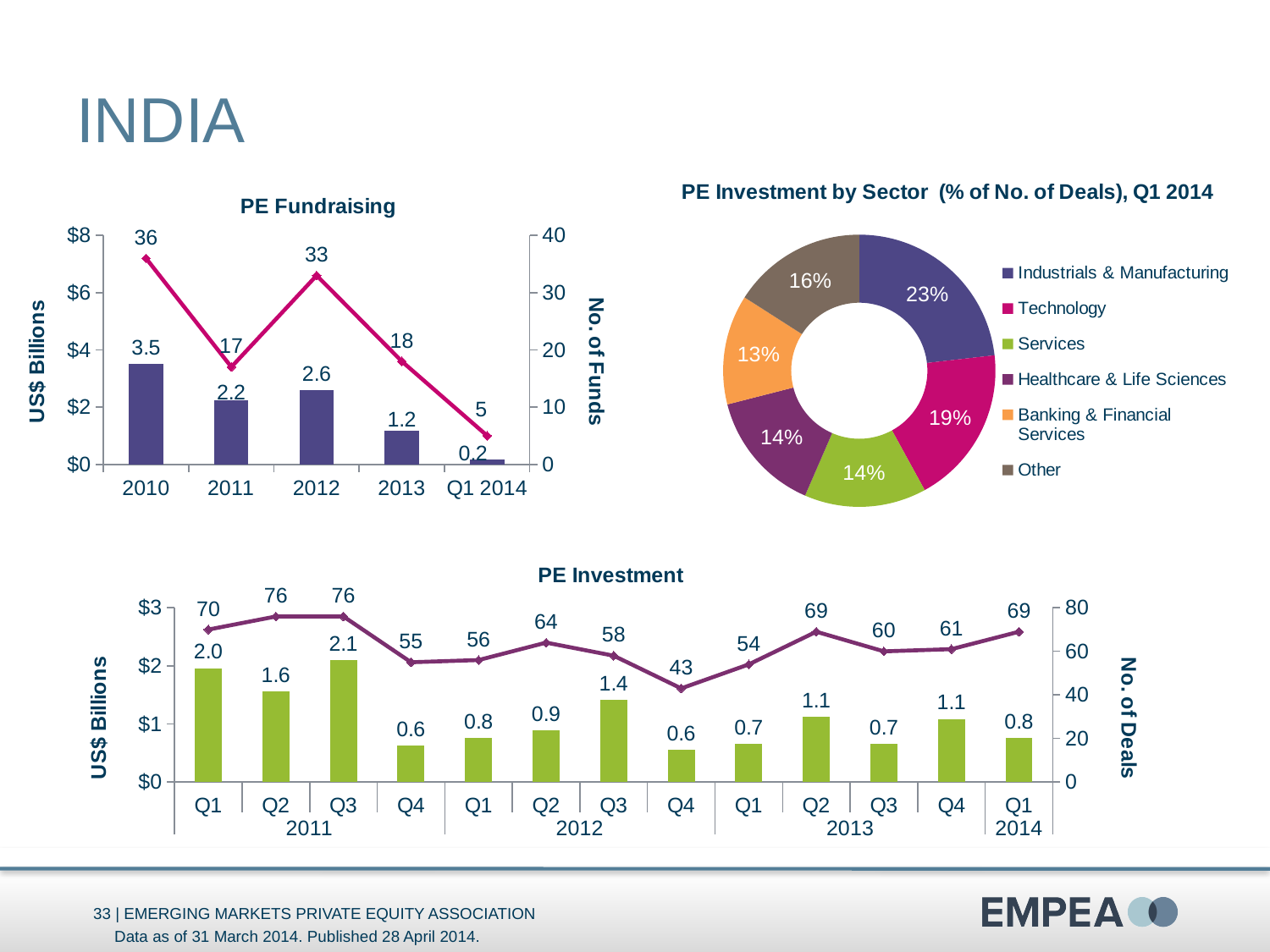
In the PE Fundraising chart, what was the US$ Billions value for 2010? 3.5 What type of chart is the PE Investment by Sector chart? Pie (donut) chart How many sectors are listed in the legend of the PE Investment by Sector chart? 6 In the PE Fundraising chart, how many funds were raised in 2012? 33 In the PE Investment chart, which quarter had the lowest No. of Deals? Q4 2012 In the PE Investment by Sector chart, what share of deals was Technology? 19% In the PE Investment chart, what was the US$ Billions value for Q3 2011? 2.1 In the PE Investment by Sector chart, which sector had the largest share of deals? Industrials & Manufacturing In the PE Investment chart, which is larger, the US$ Billions value for Q2 2011 or Q3 2012? Q2 2011 In the PE Fundraising chart, what is the difference in No. of Funds between 2010 and 2011? 19 In the PE Investment chart, what is the difference in No. of Deals between Q2 2013 and Q3 2013? 9 In the PE Fundraising chart, which year had the lowest US$ Billions value? Q1 2014